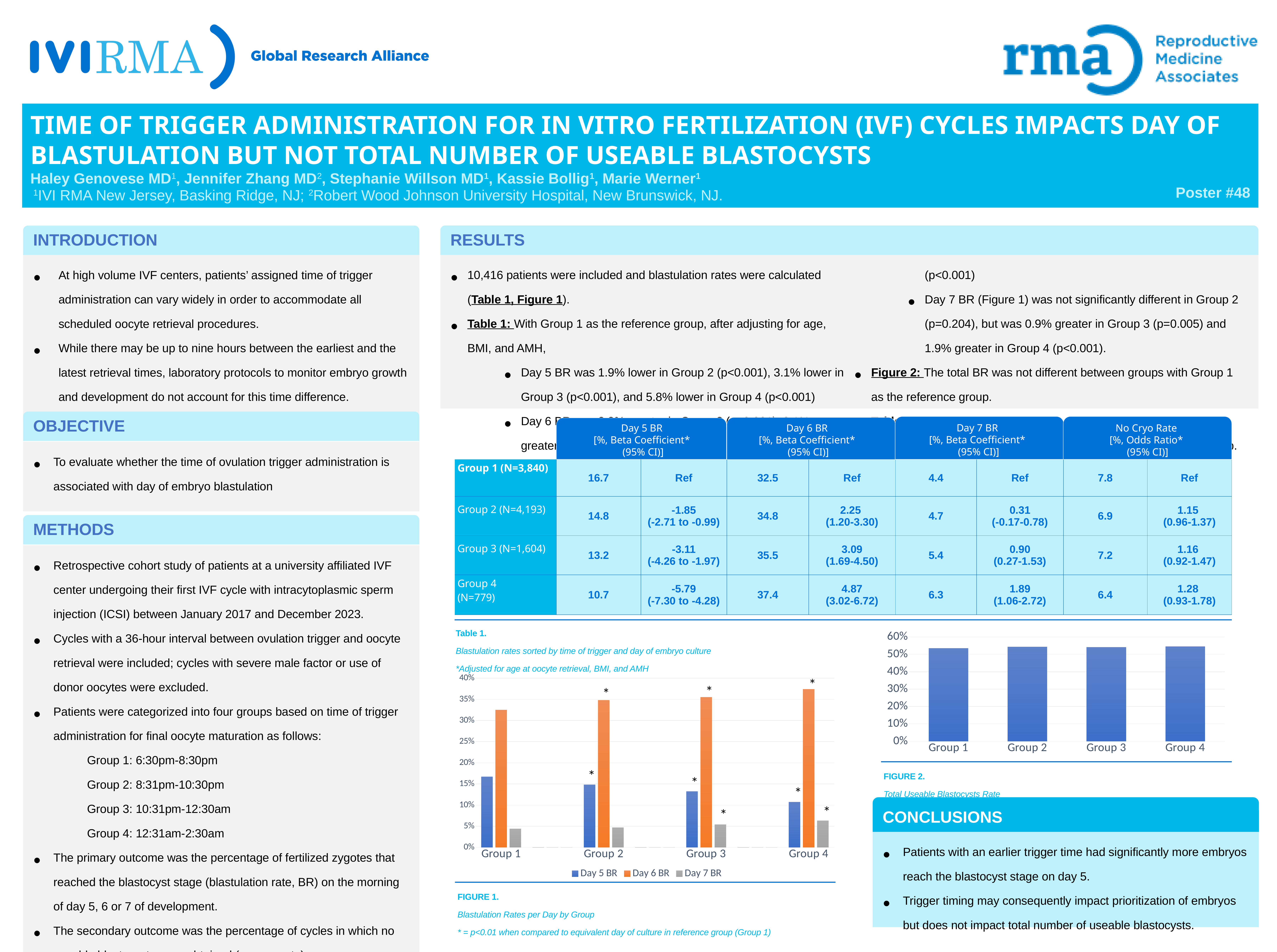
In the Figure 1 chart (Blastulation Rates per Day by Group), how many series does the legend list? 3 In the Figure 1 chart (Blastulation Rates per Day by Group), what kind of chart is shown? bar chart In the Figure 1 chart (Blastulation Rates per Day by Group), does the Day 6 BR rise or fall from Group 1 to Group 4? rise In the Figure 1 chart (Blastulation Rates per Day by Group), which group has the highest Day 6 BR? Group 4 In the Figure 1 chart (Blastulation Rates per Day by Group), for Group 1, which is larger: Day 5 BR or Day 6 BR? Day 6 BR In the Figure 1 chart (Blastulation Rates per Day by Group), is the Day 6 BR for Group 1 greater or less than 30%? greater In the Figure 1 chart (Blastulation Rates per Day by Group), which group has the lowest Day 5 BR? Group 4 In the Figure 1 chart (Blastulation Rates per Day by Group), does the Day 5 BR rise or fall from Group 1 to Group 4? fall In the Figure 1 chart (Blastulation Rates per Day by Group), what colour are the Day 6 BR bars? orange In the Figure 2 chart (Total Useable Blastocysts Rate), is the value for Group 1 greater or less than 50%? greater In the Figure 1 chart (Blastulation Rates per Day by Group), how many groups are shown on the x axis? 4 In the Figure 1 chart (Blastulation Rates per Day by Group), is the Day 5 BR for Group 4 greater or less than 15%? less